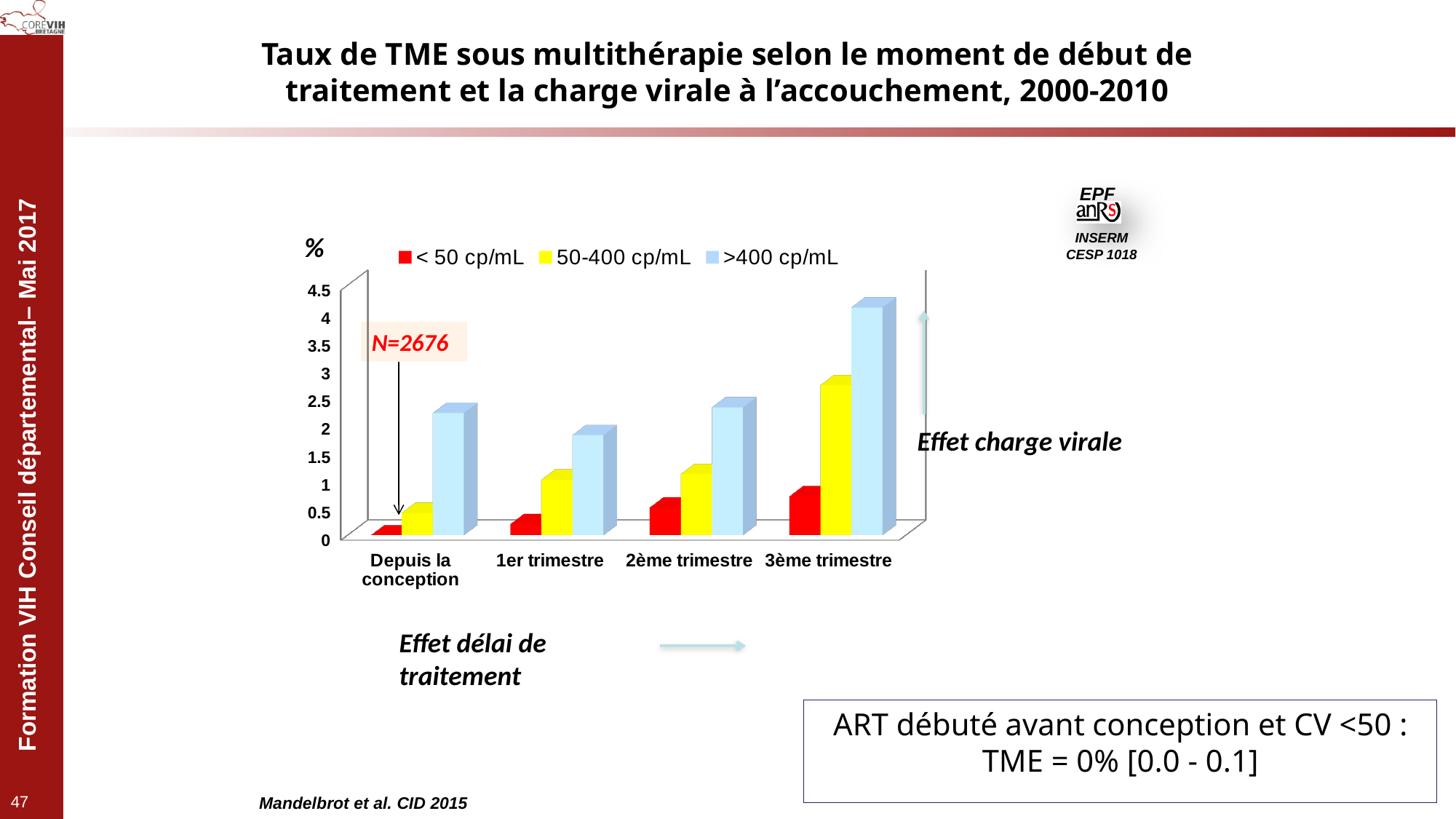
Which series does the red bar represent according to the legend? < 50 cp/mL How many categories are shown on the x axis of the chart? 4 Is the value for 50-400 cp/mL in 3ème trimestre greater or less than 2? greater Which category has the lowest value for the < 50 cp/mL series? Depuis la conception Which is larger: the 50-400 cp/mL value for 3ème trimestre or for 2ème trimestre? 3ème trimestre What unit is indicated on the y axis of the chart? % What kind of chart is shown on the slide? bar chart Do the values for the < 50 cp/mL series rise or fall from Depuis la conception to 3ème trimestre? rise Is the value for < 50 cp/mL in Depuis la conception greater or less than 0.5? less Which category has the highest value for the >400 cp/mL series? 3ème trimestre Is the value for >400 cp/mL in 3ème trimestre greater or less than 3? greater How many series does the chart legend list? 3